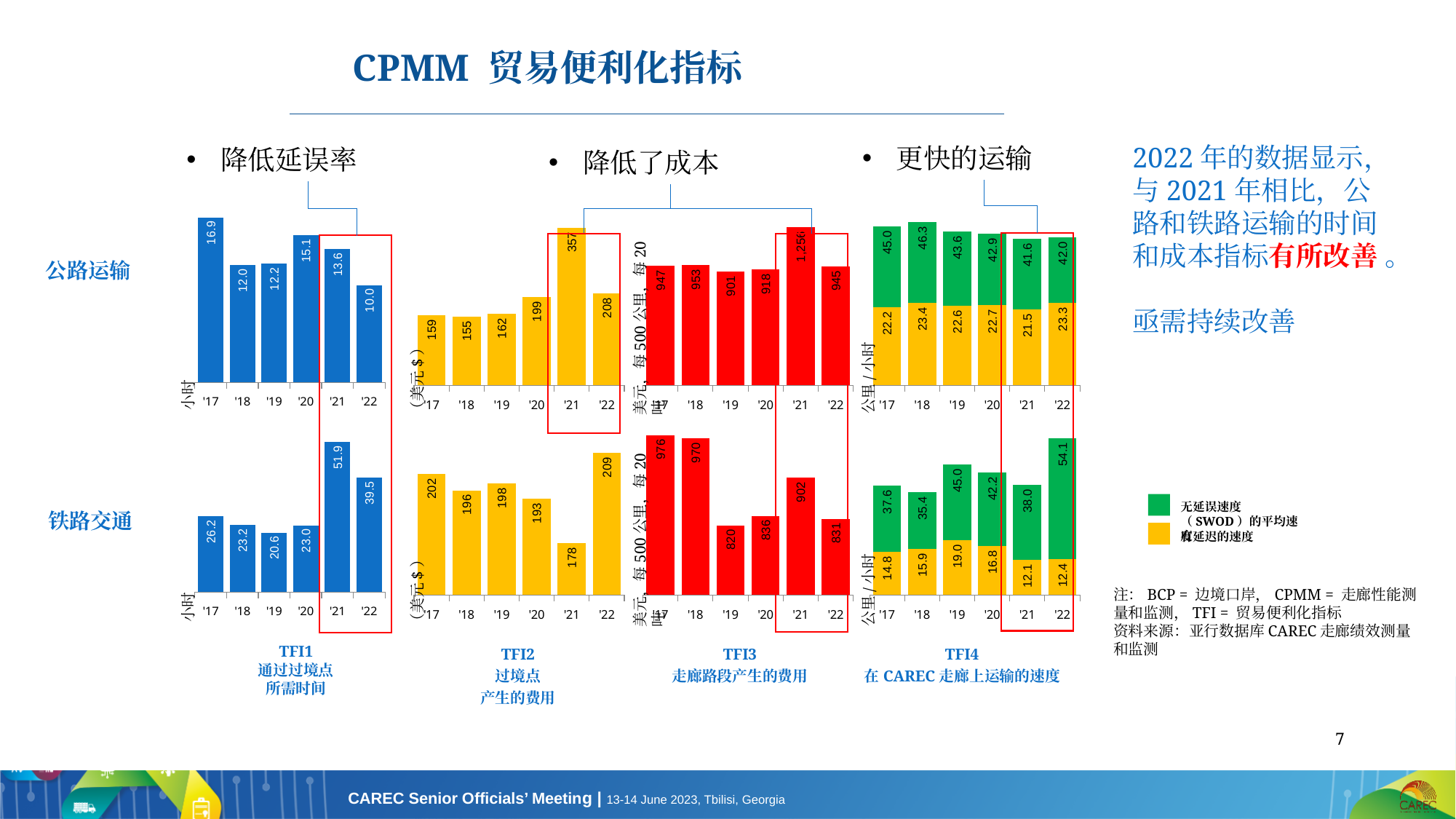
In the rail transport (铁路交通) TFI2 chart, which year has the lowest value? '21 In the road transport (公路运输) TFI2 chart, what is the value for '21? 357 In the road transport (公路运输) TFI1 chart, what is the value for '22? 10.0 In the rail transport (铁路交通) TFI1 chart, which year has the highest value? '21 How many years are shown on the x axis of the road transport (公路运输) TFI1 chart? 6 In the road transport (公路运输) TFI3 chart, what is the difference between the '21 value and the '22 value? 311 In the rail transport (铁路交通) TFI1 chart, what is the difference between the '21 value and the '22 value? 12.4 What kind of chart is the rail transport (铁路交通) TFI2 chart? bar chart In the rail transport (铁路交通) TFI4 chart, what is the green (无延误速度) value for '22? 54.1 How many series does the legend for the TFI4 charts list? 2 In the road transport (公路运输) TFI4 chart, what is the total of the stacked bar for '22? 65.3 In the rail transport (铁路交通) TFI3 chart, which is larger, the value for '17 or the value for '19? '17